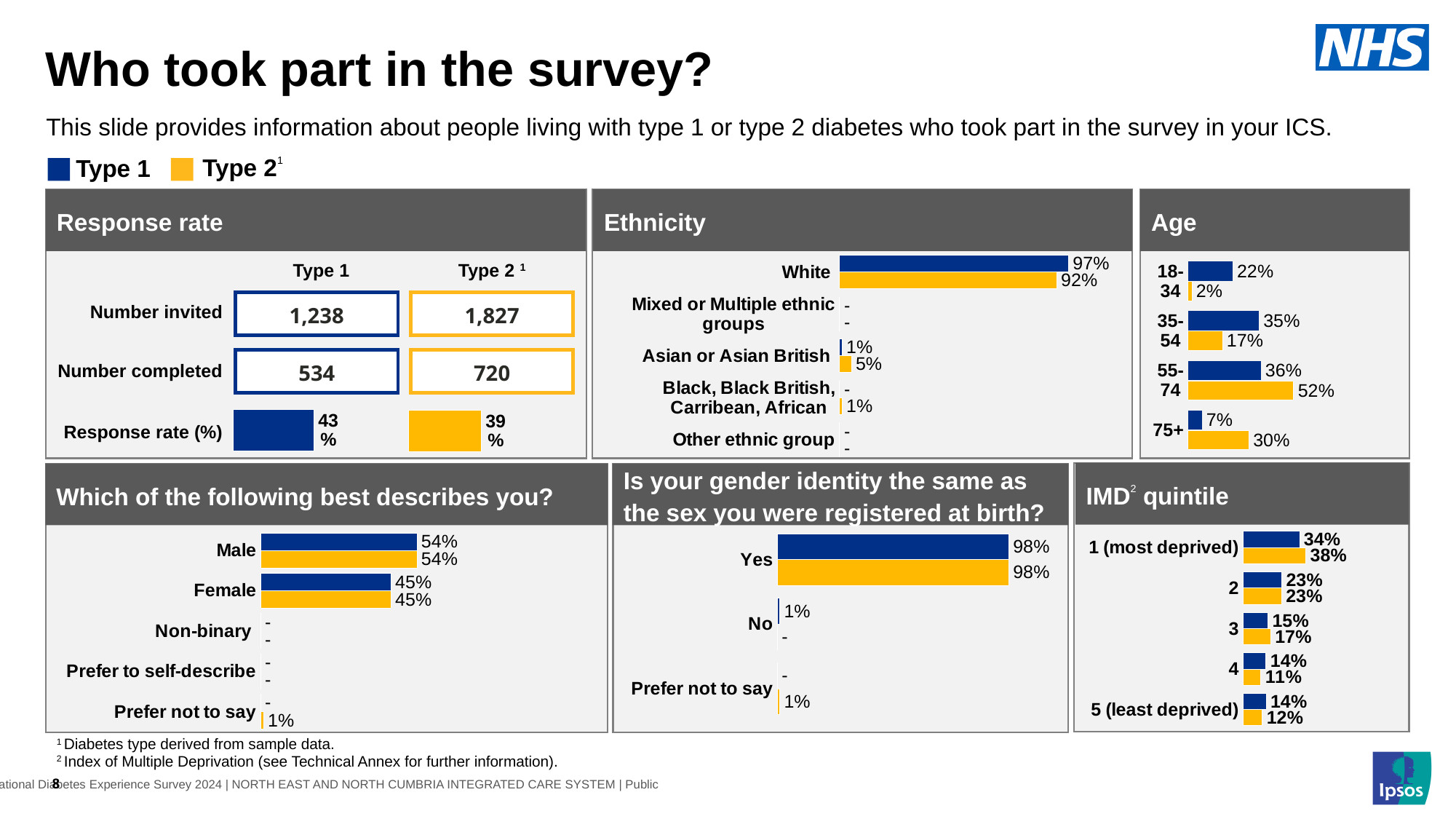
In the Age chart, what is the difference between the Type 2 and Type 1 values for the 75+ age group? 23 percentage points In the Response rate panel, what is the number completed for Type 1? 534 In the Ethnicity chart, what is the Type 1 value for White? 97% In the Ethnicity chart, what is the Type 2 value for Asian or Asian British? 5% In the Age chart, what is the Type 2 value for the 55-74 age group? 52% In the gender identity chart, what is the Type 1 value for Yes? 98% In the 'Which of the following best describes you?' chart, what is the Type 2 value for Female? 45% In the IMD quintile chart, which quintile has the lowest Type 2 value? 4 In the IMD quintile chart, what is the Type 1 value for quintile 1 (most deprived)? 34% How many series does the legend at the top of the slide list? 2 In the Response rate panel, what is the response rate for Type 2? 39% In the Age chart, which age group has the highest Type 2 value? 55-74